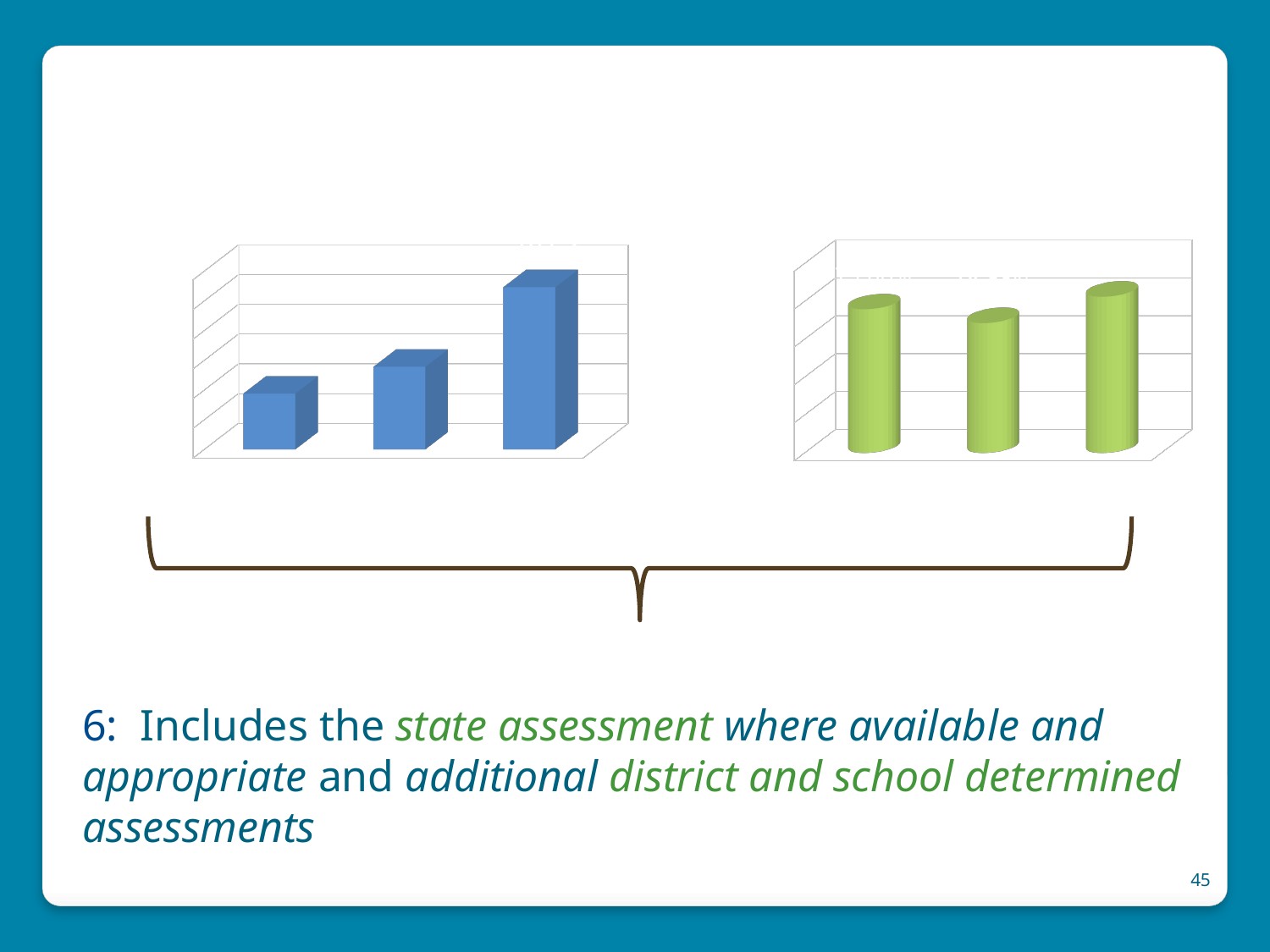
What colour are the bars in the chart on the right side of the slide? green In the chart on the right side of the slide, which bar is the shortest: the first, second or third from the left? second In the chart on the left side of the slide, which bar is the tallest: the first, second or third from the left? third In the chart on the left side of the slide, which bar is the shortest: the first, second or third from the left? first What kind of chart is the chart on the left side of the slide? bar chart How many bars does the chart on the right side of the slide show? 3 How many bars does the chart on the left side of the slide show? 3 In the chart on the left side of the slide, which is taller: the second bar or the third bar? third bar In the chart on the right side of the slide, which is taller: the first bar or the second bar? first bar What colour are the bars in the chart on the left side of the slide? blue What kind of chart is the chart on the right side of the slide? bar chart In the chart on the left side of the slide, do the bar values rise or fall from left to right? rise